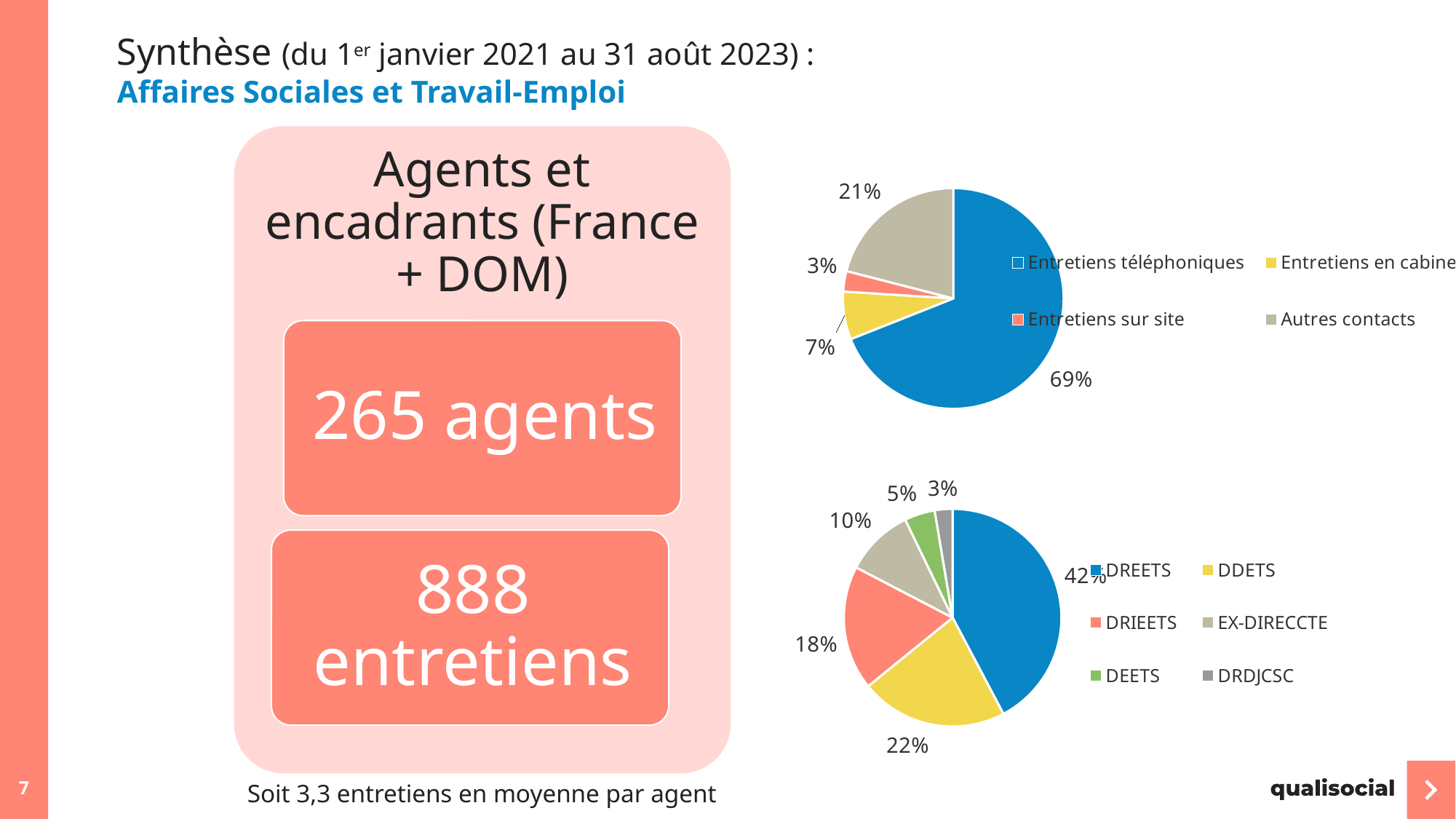
In the bottom pie chart, which is larger, DDETS or DRIEETS? DDETS In the top pie chart, what share is Entretiens sur site? 3% In the top pie chart, what share is Entretiens téléphoniques? 69% What kind of chart is the bottom chart? Pie chart In the bottom pie chart, what share is DREETS? 42% In the top pie chart, what share is Autres contacts? 21% In the top pie chart, which category has the smallest share? Entretiens sur site How many categories does the legend of the bottom pie chart list? 6 In the top pie chart, what is the difference between Entretiens téléphoniques and Autres contacts? 48 percentage points In the bottom pie chart, what share is EX-DIRECCTE? 10% In the top pie chart, which category has the largest share? Entretiens téléphoniques In the bottom pie chart, which category has the smallest share? DRDJCSC